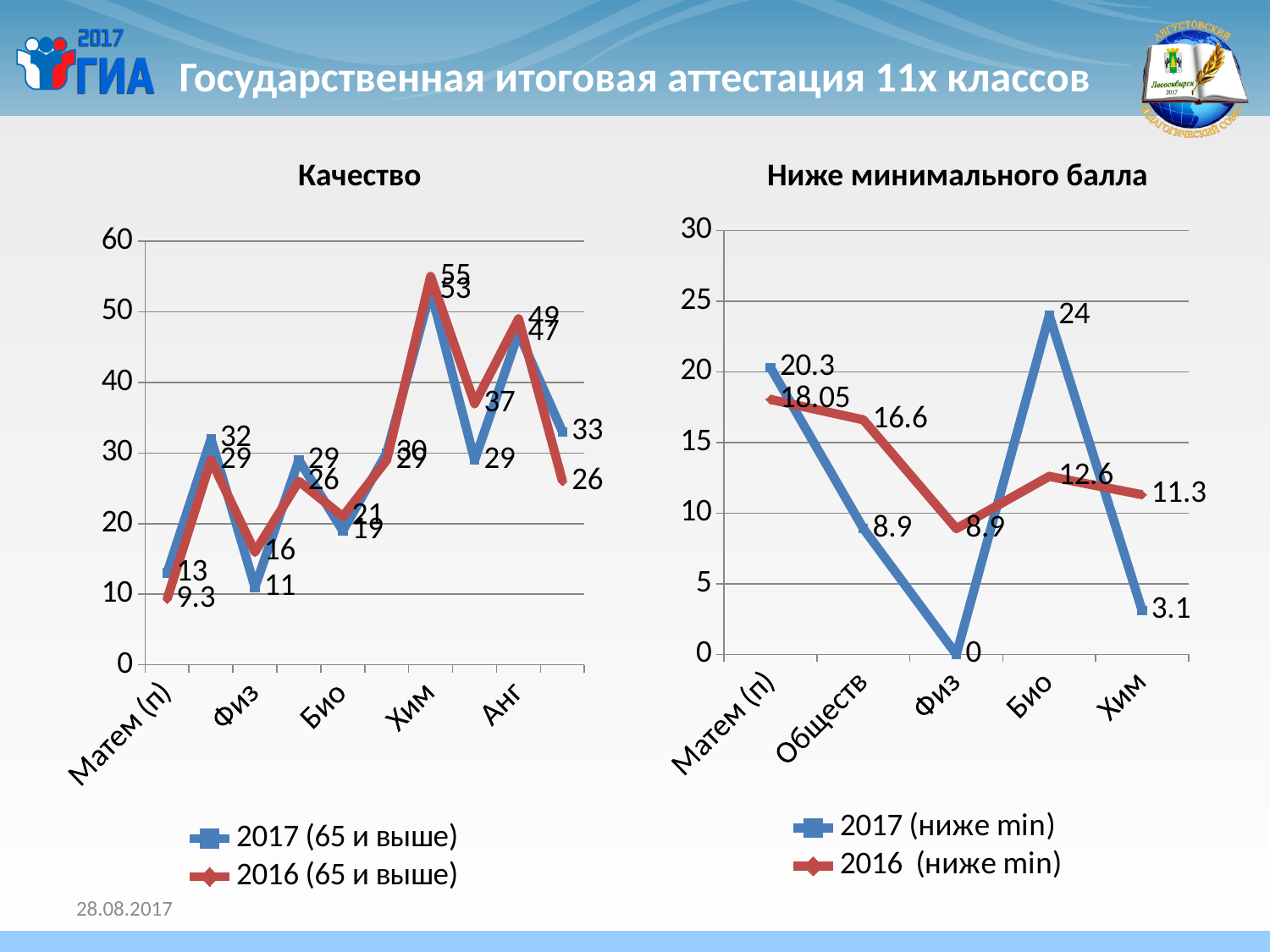
In the chart titled "Ниже минимального балла", what is the value of the 2017 (ниже min) series for Био? 24 In the chart titled "Ниже минимального балла", which category has the highest value for the 2017 (ниже min) series? Био In the chart titled "Ниже минимального балла", what is the difference between the 2016 and 2017 values for Хим? 8.2 In the chart titled "Ниже минимального балла", what is the difference between the 2017 and 2016 values for Матем (п)? 2.25 In the chart titled "Ниже минимального балла", how many categories are shown on the x axis? 5 What kind of chart is the chart titled "Качество"? line chart In the chart titled "Качество", how many series does the legend list? 2 In the chart titled "Качество", what is the value of the 2016 (65 и выше) series for Матем (п)? 9.3 In the chart titled "Ниже минимального балла", what is the value of the 2016 (ниже min) series for Обществ? 16.6 In the chart titled "Качество", which series has the larger value for Физ, 2017 (65 и выше) or 2016 (65 и выше)? 2016 (65 и выше) In the chart titled "Качество", what is the value of the 2017 (65 и выше) series for Хим? 53 In the chart titled "Ниже минимального балла", which category has the lowest value for the 2017 (ниже min) series? Физ